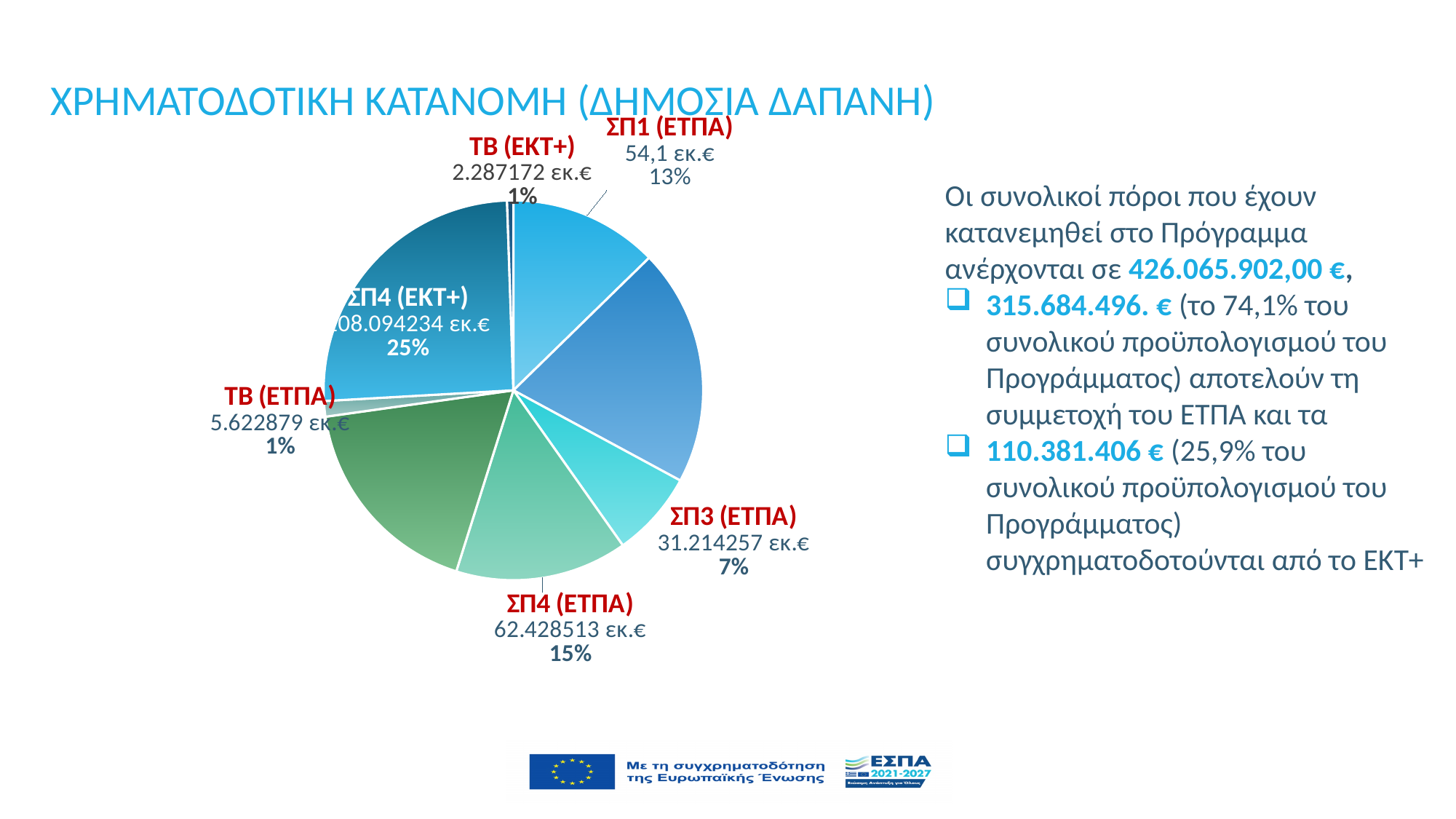
What is the difference in percentage share between ΣΠ4 (ΕΤΠΑ) and ΣΠ3 (ΕΤΠΑ)? 8 percentage points What type of chart is shown on the slide? pie chart What value is shown for ΣΠ4 (ΕΤΠΑ)? 62.428513 εκ.€ What is the title of the chart on the slide? ΧΡΗΜΑΤΟΔΟΤΙΚΗ ΚΑΤΑΝΟΜΗ (ΔΗΜΟΣΙΑ ΔΑΠΑΝΗ) What value is shown for ΣΠ3 (ΕΤΠΑ)? 31.214257 εκ.€ What value is shown for ΤΒ (ΕΤΠΑ)? 5.622879 εκ.€ Which is larger, the slice for ΣΠ4 (ΕΤΠΑ) or the slice for ΣΠ3 (ΕΤΠΑ)? ΣΠ4 (ΕΤΠΑ) What share of the pie does ΣΠ4 (ΕΚΤ+) represent? 25% What value is shown for ΤΒ (ΕΚΤ+)? 2.287172 εκ.€ What share of the pie does ΣΠ4 (ΕΤΠΑ) represent? 15% What share of the pie does ΣΠ1 (ΕΤΠΑ) represent? 13% What value is shown for ΣΠ1 (ΕΤΠΑ)? 54,1 εκ.€